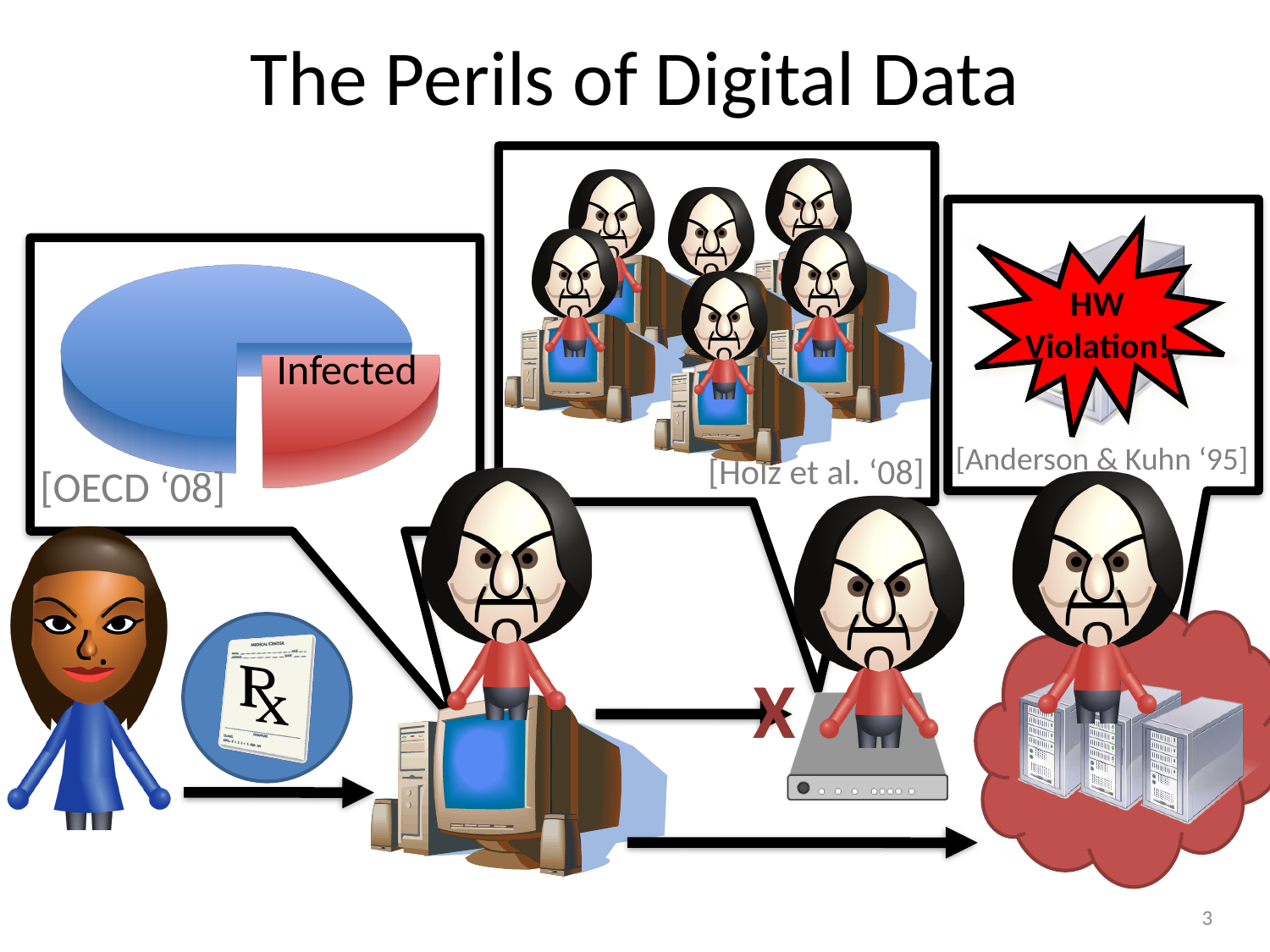
In the pie chart, what is the label on the red slice? Infected How many slices does the pie chart in the [OECD '08] box have? 2 What kind of chart is shown in the box labelled [OECD '08]? pie chart In the pie chart, is the Infected slice larger or smaller than the blue slice? smaller What colour is the Infected slice of the pie chart? red Which slice of the pie chart is the largest, the blue slice or the Infected slice? the blue slice Which slice of the pie chart is the smallest? Infected